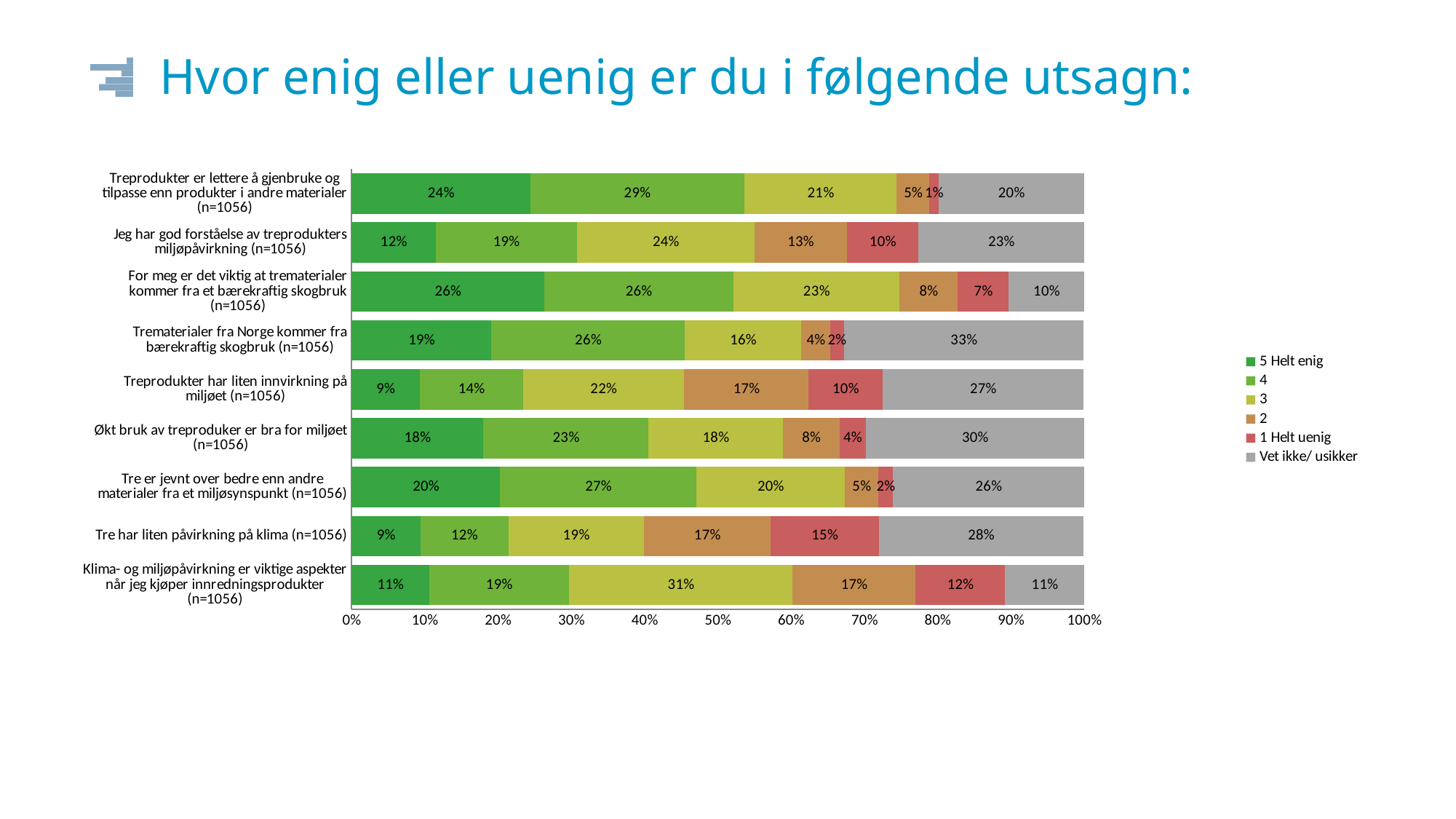
Which has a larger "4" share: "Treprodukter er lettere å gjenbruke og tilpasse enn produkter i andre materialer" or "Tre er jevnt over bedre enn andre materialer fra et miljøsynspunkt"? Treprodukter er lettere å gjenbruke og tilpasse enn produkter i andre materialer What is the "Vet ikke/ usikker" share for "Tre har liten påvirkning på klima"? 28% How many series does the legend list? 6 Which statement has the highest "Vet ikke/ usikker" share? Trematerialer fra Norge kommer fra bærekraftig skogbruk What kind of chart is shown on the slide? Stacked horizontal bar chart What is the "1 Helt uenig" share for "Jeg har god forståelse av treprodukters miljøpåvirkning"? 10% How many statements are shown in the chart? 9 What percentage of respondents answered "5 Helt enig" to "Trematerialer fra Norge kommer fra bærekraftig skogbruk"? 19% What percentage answered "3" for "Klima- og miljøpåvirkning er viktige aspekter når jeg kjøper innredningsprodukter"? 31% Which statement has the highest "5 Helt enig" share? For meg er det viktig at trematerialer kommer fra et bærekraftig skogbruk What is the difference between the "1 Helt uenig" shares for "Tre har liten påvirkning på klima" and "Økt bruk av treproduker er bra for miljøet"? 11 percentage points Which statement has the lowest "5 Helt enig" share? Treprodukter har liten innvirkning på miljøet and Tre har liten påvirkning på klima (both 9%)